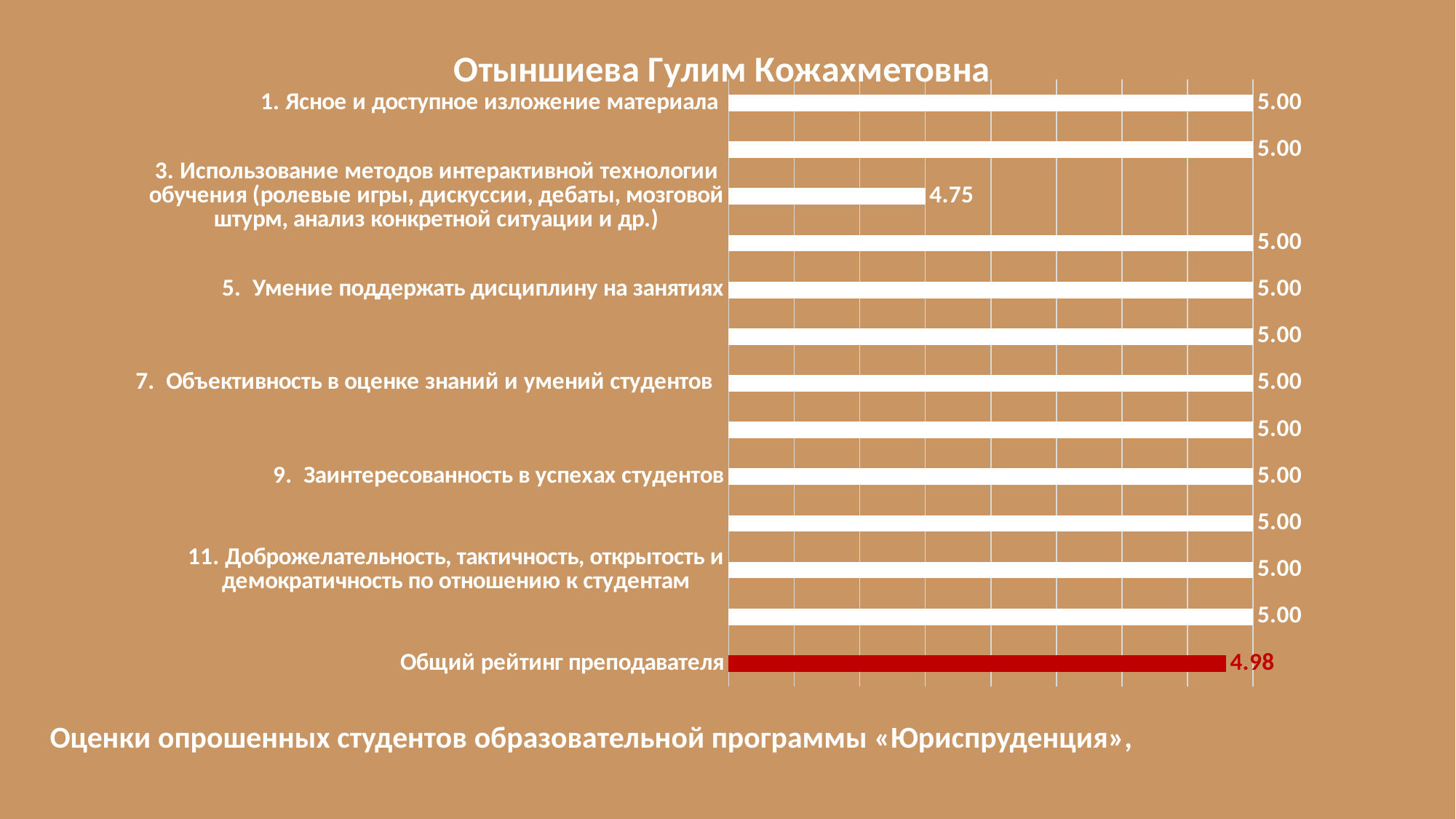
What is the value for "7. Объективность в оценке знаний и умений студентов"? 5.00 What is the value for "1. Ясное и доступное изложение материала"? 5.00 What kind of chart is shown on the slide? Bar chart What is the value for "Общий рейтинг преподавателя"? 4.98 How many bars are plotted in the chart? 13 What is the value for "11. Доброжелательность, тактичность, открытость и демократичность по отношению к студентам"? 5.00 What is the difference between "Общий рейтинг преподавателя" and "3. Использование методов интерактивной технологии обучения"? 0.23 What is the title of the chart? Отыншиева Гулим Кожахметовна Which category has the lowest value? 3. Использование методов интерактивной технологии обучения What is the difference between the value for "1. Ясное и доступное изложение материала" and the value for "3. Использование методов интерактивной технологии обучения"? 0.25 What is the value for "3. Использование методов интерактивной технологии обучения"? 4.75 Which is larger: the value for "Общий рейтинг преподавателя" or the value for "3. Использование методов интерактивной технологии обучения"? Общий рейтинг преподавателя